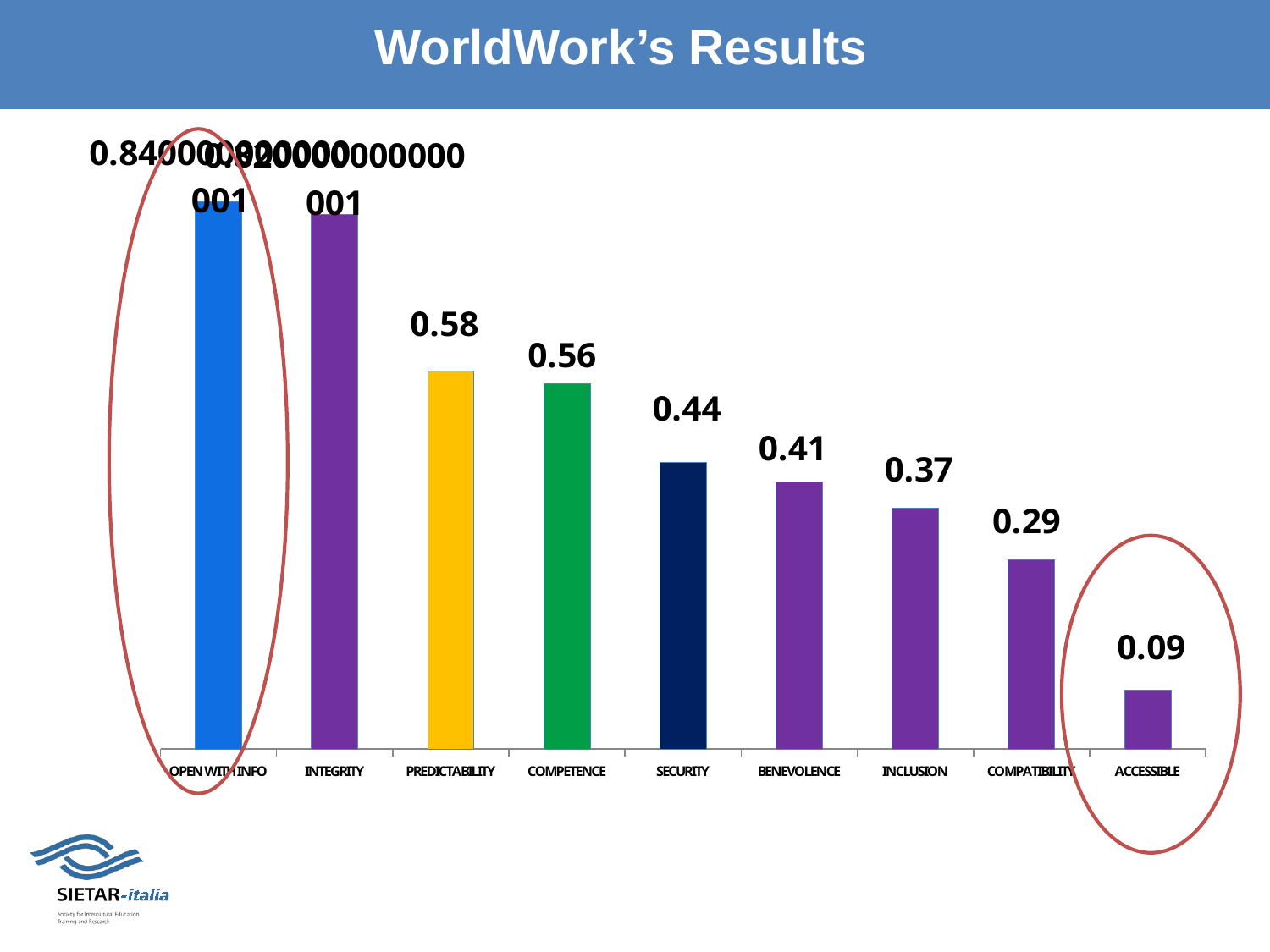
What is the value for BENEVOLENCE? 0.41 Which category has the highest value? OPEN WITH INFO What is the value for COMPATIBILITY? 0.29 Which category has the lowest value? ACCESSIBLE What is the value for INCLUSION? 0.37 How many categories are shown in the chart? 9 What is the difference between the values for PREDICTABILITY and ACCESSIBLE? 0.49 What is the value for SECURITY? 0.44 What is the value for ACCESSIBLE? 0.09 What is the value for PREDICTABILITY? 0.58 Which is larger, the value for SECURITY or the value for INCLUSION? SECURITY What is the value for COMPETENCE? 0.56